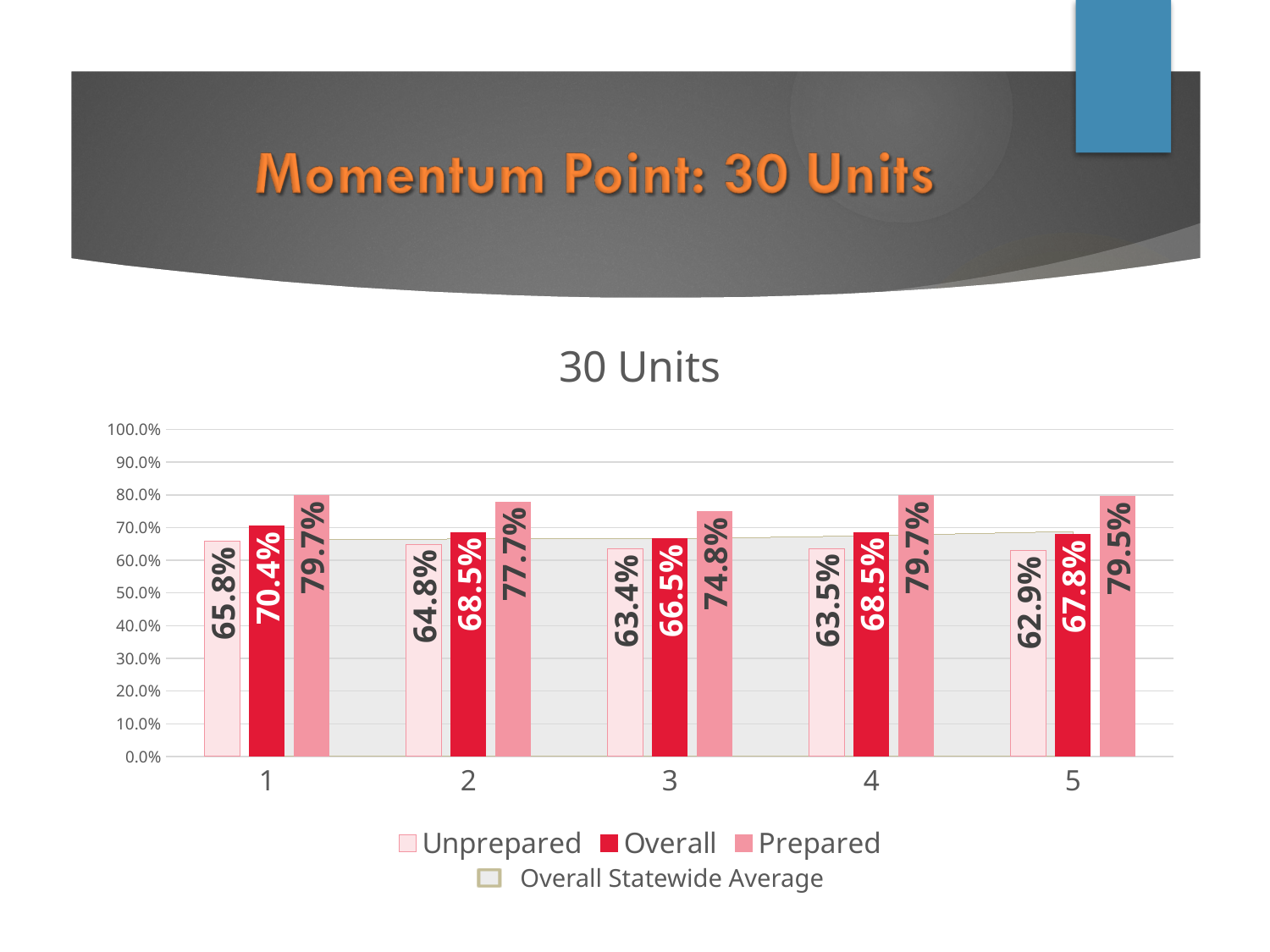
What is the title of the chart? 30 Units What is the Unprepared value for category 5? 62.9% Which category has the lowest Unprepared value? 5 What is the Overall value for category 3? 66.5% What kind of chart is shown? Combination bar and area chart Is the Overall value for category 4 larger than the Overall value for category 5? Yes How many entries does the legend list? 4 How many categories are shown on the x axis? 5 What is the Prepared value for category 1? 79.7% What is the difference between the Prepared and Unprepared values for category 2? 12.9% Which category has the highest Overall value? 1 Which category has the lowest Prepared value? 3